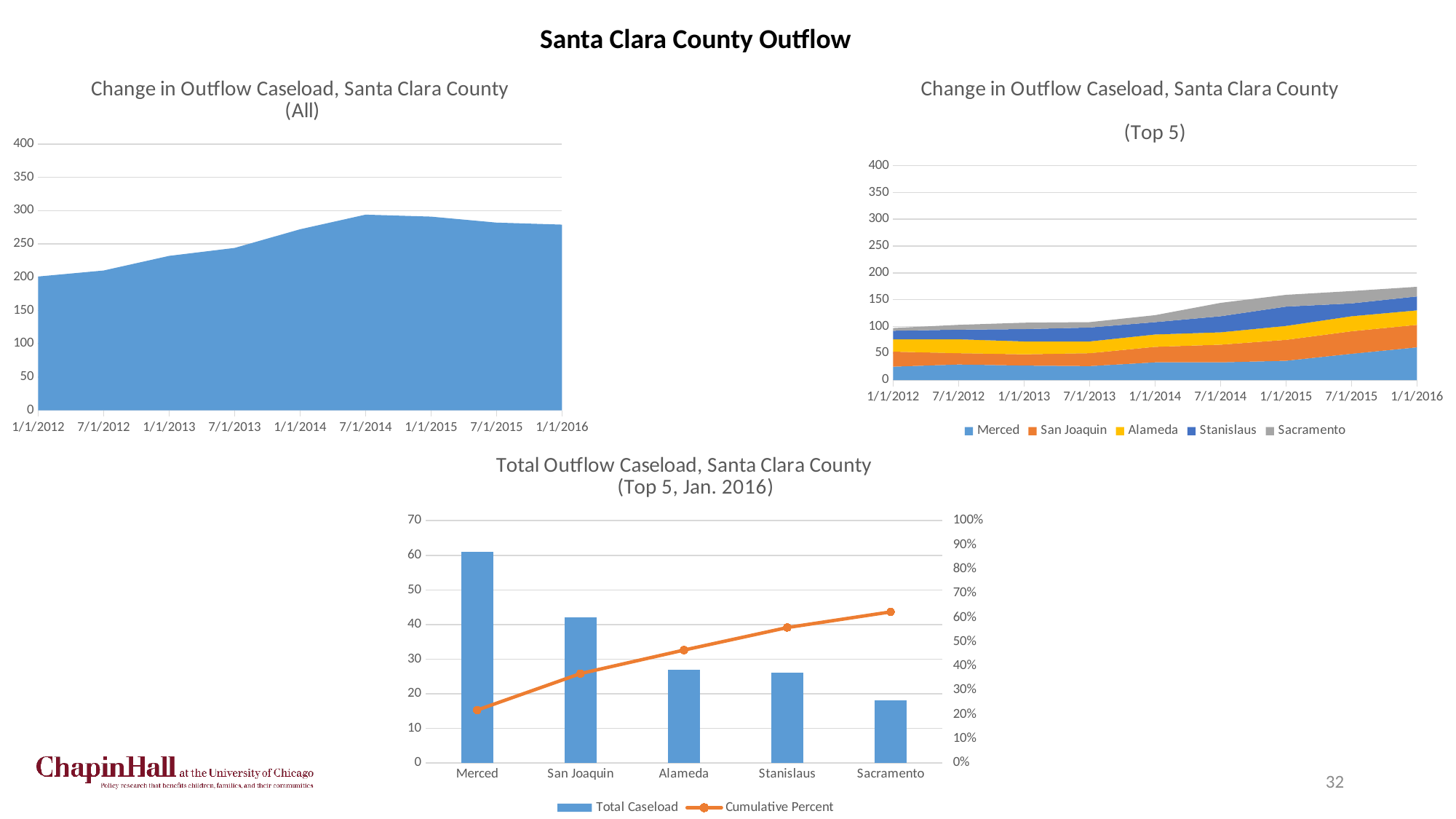
How many counties are shown on the x axis of the 'Total Outflow Caseload, Santa Clara County (Top 5, Jan. 2016)' chart? 5 In the 'Change in Outflow Caseload, Santa Clara County (All)' chart, is the value at 1/1/2012 greater or less than 250? less In the 'Change in Outflow Caseload, Santa Clara County (Top 5)' chart, is the stacked total at 1/1/2016 greater or less than 150? greater How many series does the legend of the 'Change in Outflow Caseload, Santa Clara County (Top 5)' chart list? 5 In the 'Total Outflow Caseload, Santa Clara County (Top 5, Jan. 2016)' chart, which county has the lowest total caseload? Sacramento What type of chart is the 'Change in Outflow Caseload, Santa Clara County (All)' chart? area chart In the 'Change in Outflow Caseload, Santa Clara County (All)' chart, is the value at 7/1/2014 greater or less than 250? greater In the 'Change in Outflow Caseload, Santa Clara County (Top 5)' chart, which county is shown as the bottom (blue) layer of the stack? Merced In the 'Total Outflow Caseload, Santa Clara County (Top 5, Jan. 2016)' chart, which county has the highest total caseload? Merced In the 'Change in Outflow Caseload, Santa Clara County (All)' chart, do values overall rise or fall from 1/1/2012 to 1/1/2016? rise What type of chart is the 'Total Outflow Caseload, Santa Clara County (Top 5, Jan. 2016)' chart? bar chart with a line